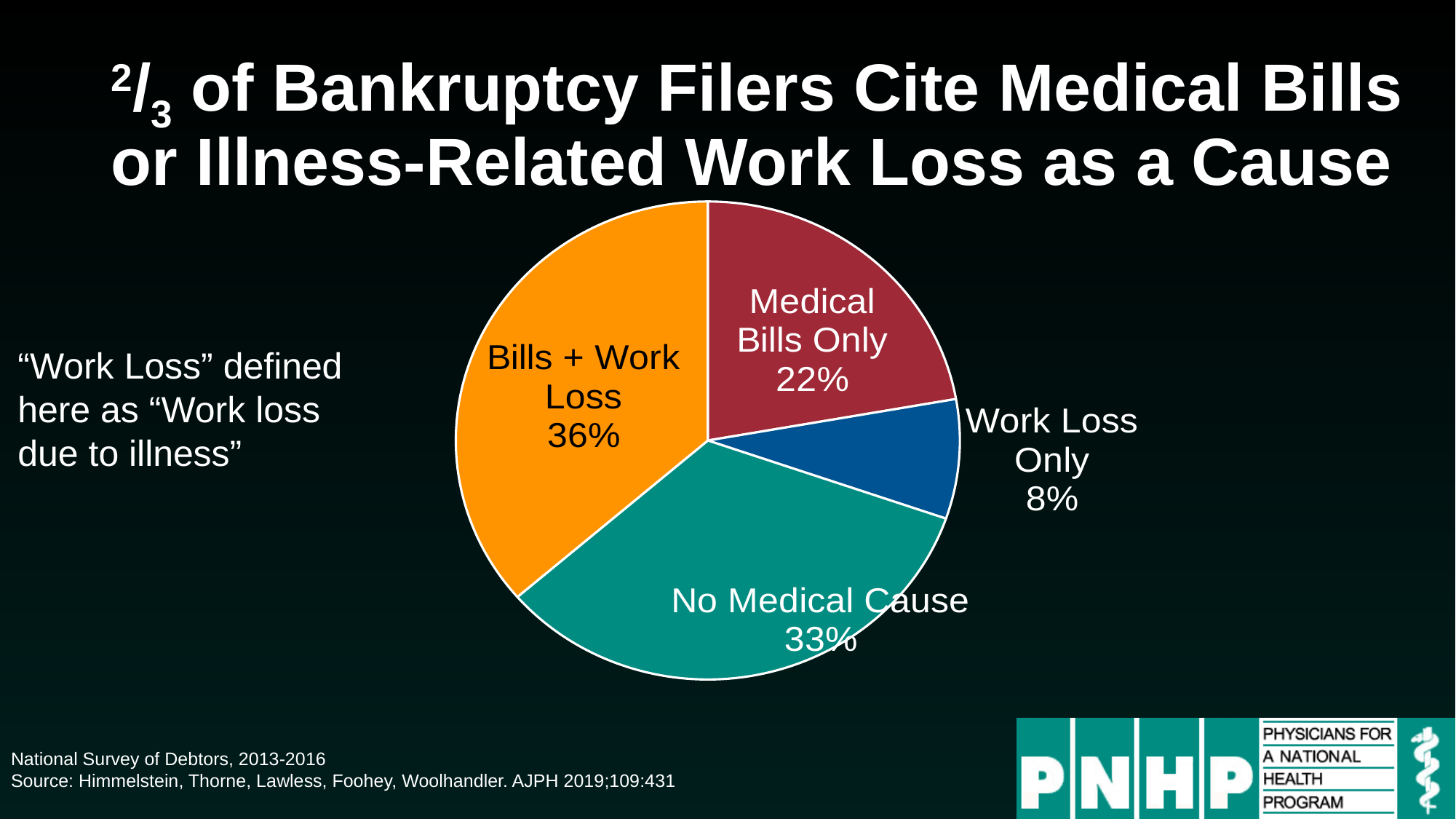
What percentage of bankruptcy filers cited Bills + Work Loss? 36% Which category has the smallest share of the pie? Work Loss Only What is the difference in percentage points between Bills + Work Loss and Medical Bills Only? 14 What percentage of bankruptcy filers had No Medical Cause? 33% How many slices does the pie chart have? 4 Which category has the largest share of the pie? Bills + Work Loss What kind of chart is shown on the slide? Pie chart Which is larger, the share for Medical Bills Only or the share for Work Loss Only? Medical Bills Only What percentage of bankruptcy filers cited Medical Bills Only? 22% What percentage of bankruptcy filers cited Work Loss Only? 8% What is the combined percentage of Medical Bills Only and Work Loss Only? 30% What colour is the Bills + Work Loss slice? Orange